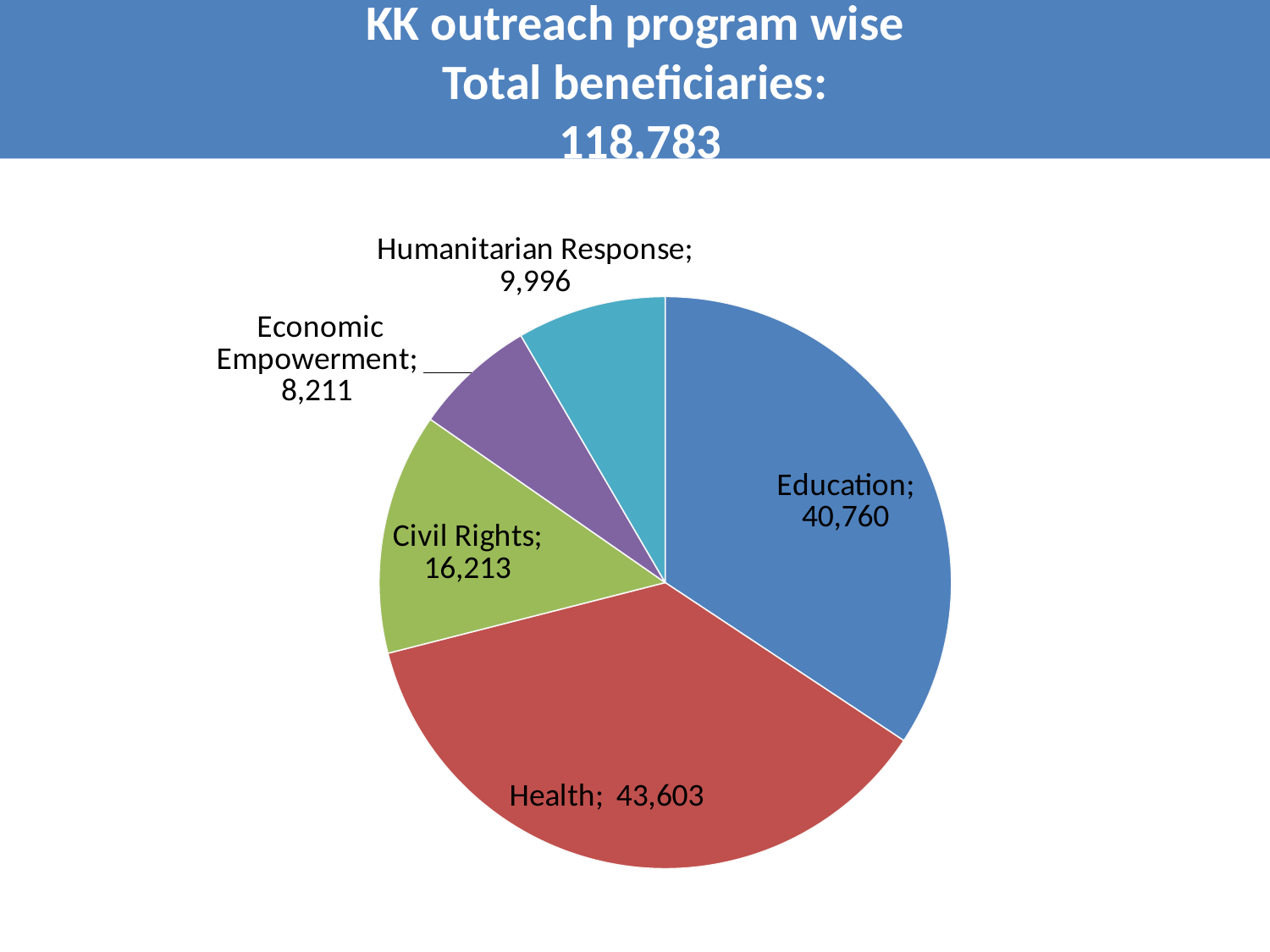
Which program has the smallest number of beneficiaries? Economic Empowerment Which has more beneficiaries, Civil Rights or Humanitarian Response? Civil Rights What is the value shown for Economic Empowerment? 8,211 What total number of beneficiaries is stated in the chart title? 118,783 What is the difference in beneficiaries between Health and Education? 2,843 What is the value shown for Humanitarian Response? 9,996 What type of chart is shown on the slide? Pie chart How many beneficiaries does the Education slice show? 40,760 Which program has the largest number of beneficiaries? Health What is the value shown for Civil Rights? 16,213 What is the value shown for Health? 43,603 How many program slices does the pie chart have? 5